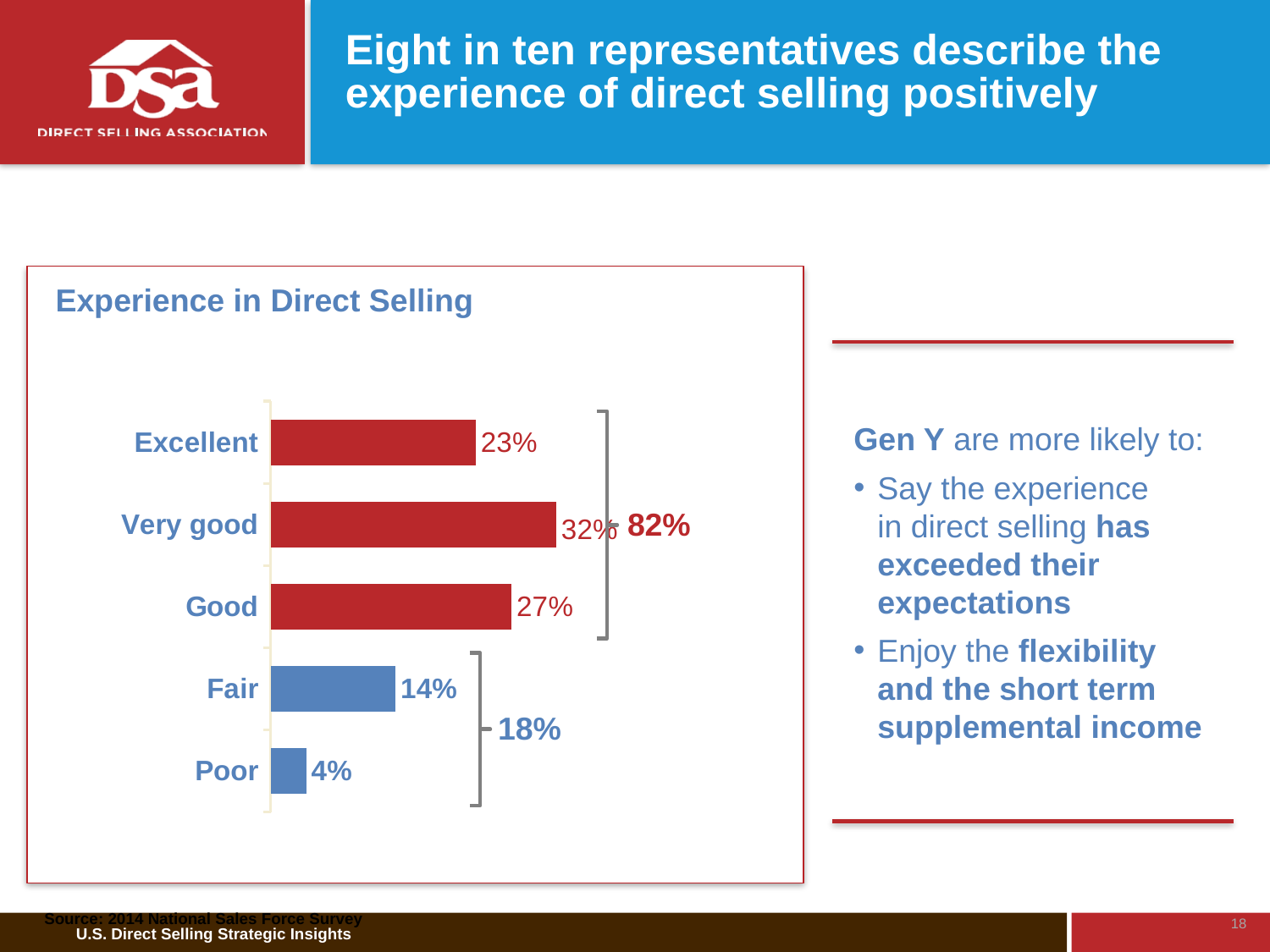
Which category has the lowest value in the Experience in Direct Selling chart? Poor What kind of chart is used to show Experience in Direct Selling? Bar chart What is the difference between the Fair and Poor values? 10% What is the title of the chart on the slide? Experience in Direct Selling What percentage of representatives rate their experience in direct selling as Excellent? 23% What is the difference between the Good and Excellent values? 4% What percentage of representatives rate their experience as Poor? 4% How many categories are shown in the Experience in Direct Selling chart? 5 What combined percentage is shown by the bracket grouping Excellent, Very good and Good? 82% Which is larger, the value for Good or the value for Fair? Good Which category has the highest value in the Experience in Direct Selling chart? Very good What is the value for Very good in the Experience in Direct Selling chart? 32%